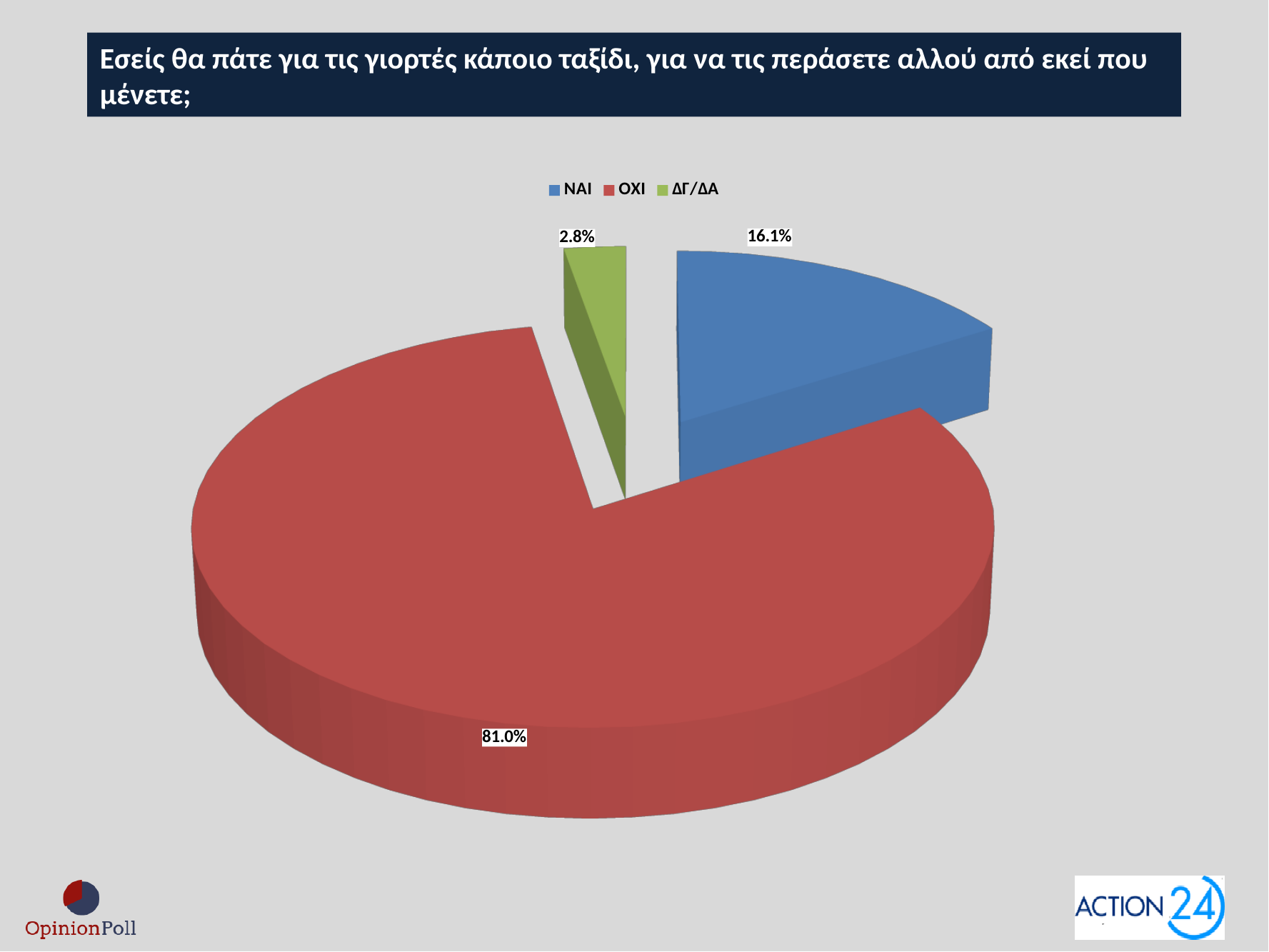
Which response has the largest share of the pie? ΟΧΙ What kind of chart is shown on the slide? Pie chart Which is larger, the share for ΝΑΙ or the share for ΔΓ/ΔΑ? ΝΑΙ What percentage of respondents answered ΝΑΙ? 16.1% What percentage of respondents answered ΔΓ/ΔΑ? 2.8% What is the difference in percentage points between ΟΧΙ and ΝΑΙ? 64.9 What colour is the slice for ΟΧΙ? Red How many slices does the pie chart have? 3 What is the difference in percentage points between ΝΑΙ and ΔΓ/ΔΑ? 13.3 How many entries does the legend list? 3 What percentage of respondents answered ΟΧΙ? 81.0% Which response has the smallest share of the pie? ΔΓ/ΔΑ